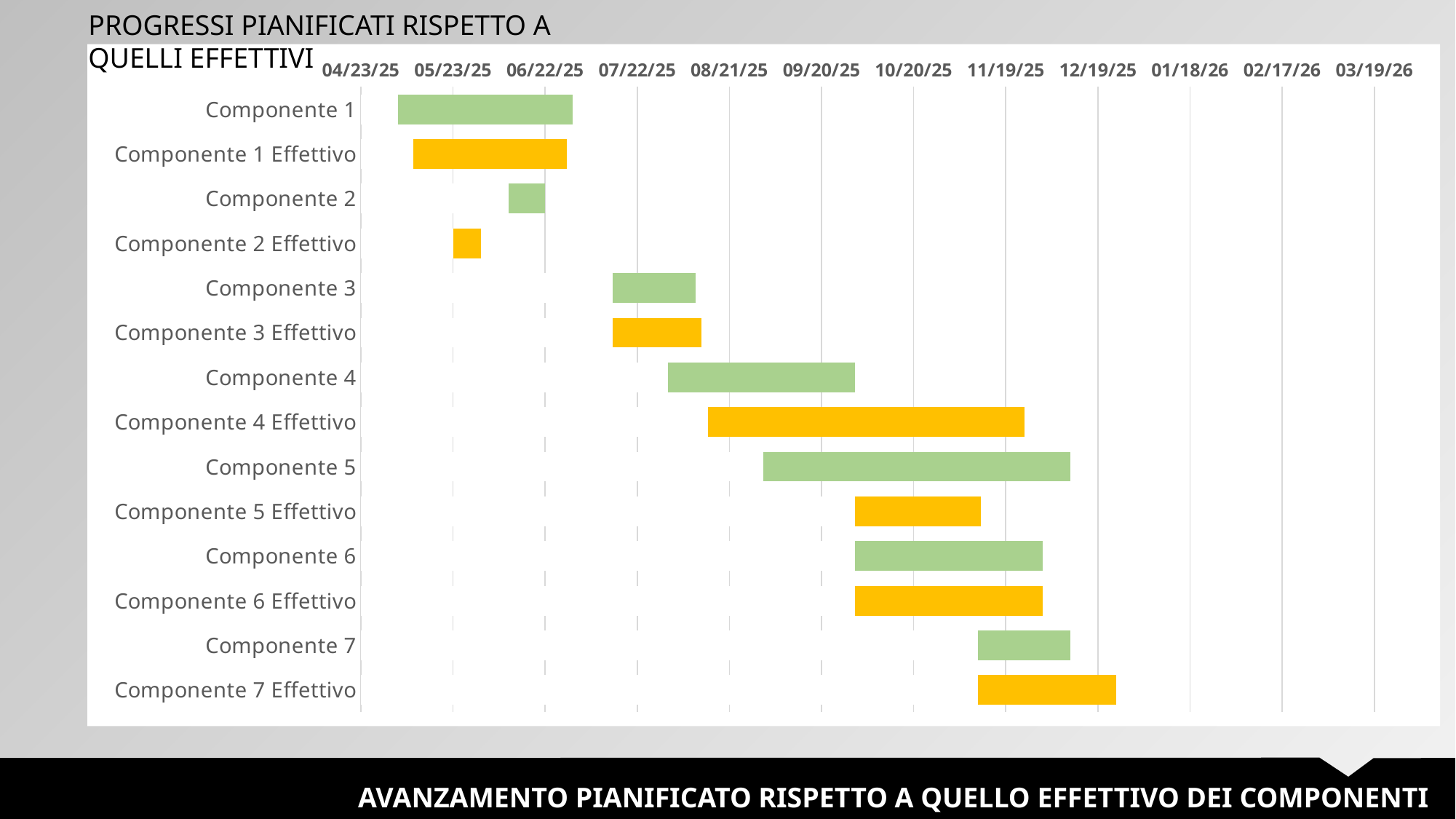
What colour are the bars for the 'Effettivo' rows? Yellow/orange What kind of chart is shown on the slide? Bar chart (Gantt chart) How many components are compared in the chart? 7 What is the title of the chart? PROGRESSI PIANIFICATI RISPETTO A QUELLI EFFETTIVI What is the last date label shown on the horizontal axis? 03/19/26 Which bar is longer: Componente 4 or Componente 4 Effettivo? Componente 4 Effettivo Does the bar for Componente 6 end before or after 12/19/25? before Which bar is longer: Componente 5 or Componente 5 Effettivo? Componente 5 What is the first date label shown on the horizontal axis? 04/23/25 Does the bar for Componente 1 start before or after 04/23/25? after How many category rows are listed on the vertical axis of the chart? 14 Does the bar for Componente 7 Effettivo end before or after 12/19/25? after